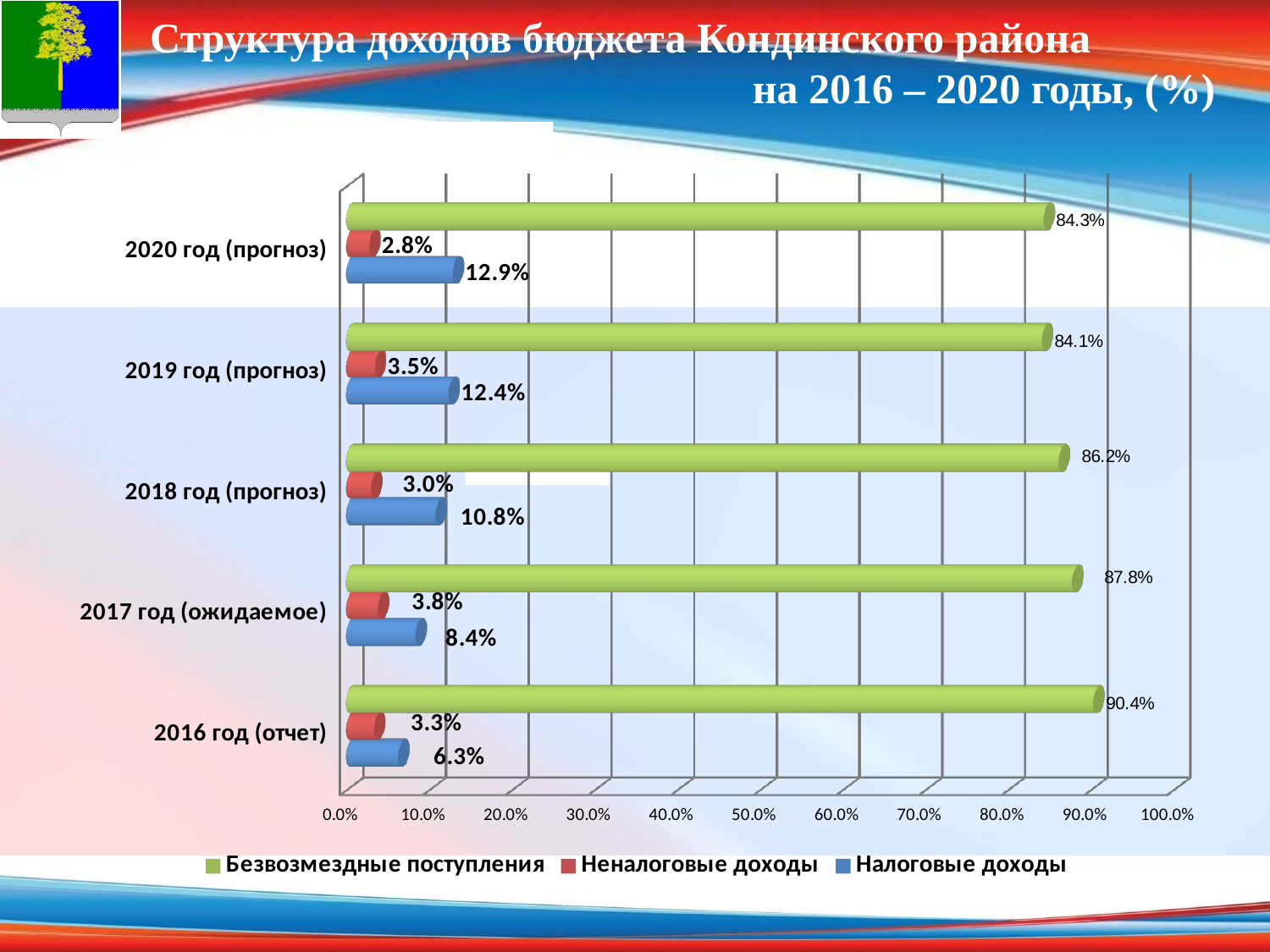
What is the value of Безвозмездные поступления for 2016 год (отчет)? 90.4% Which is larger: Неналоговые доходы in 2019 год (прогноз) or in 2020 год (прогноз)? 2019 год (прогноз) What is the value of Налоговые доходы for 2020 год (прогноз)? 12.9% What is the value of Неналоговые доходы for 2017 год (ожидаемое)? 3.8% What type of chart is shown on the slide? bar chart How many series does the legend list? 3 Which year has the highest value for Безвозмездные поступления? 2016 год (отчет) Which year has the lowest value for Налоговые доходы? 2016 год (отчет) What is the difference between Налоговые доходы in 2020 год (прогноз) and 2016 год (отчет)? 6.6% Does the value of Налоговые доходы rise or fall from 2016 to 2020? rise Which series is shown in green in the legend? Безвозмездные поступления How many year categories are shown on the chart? 5